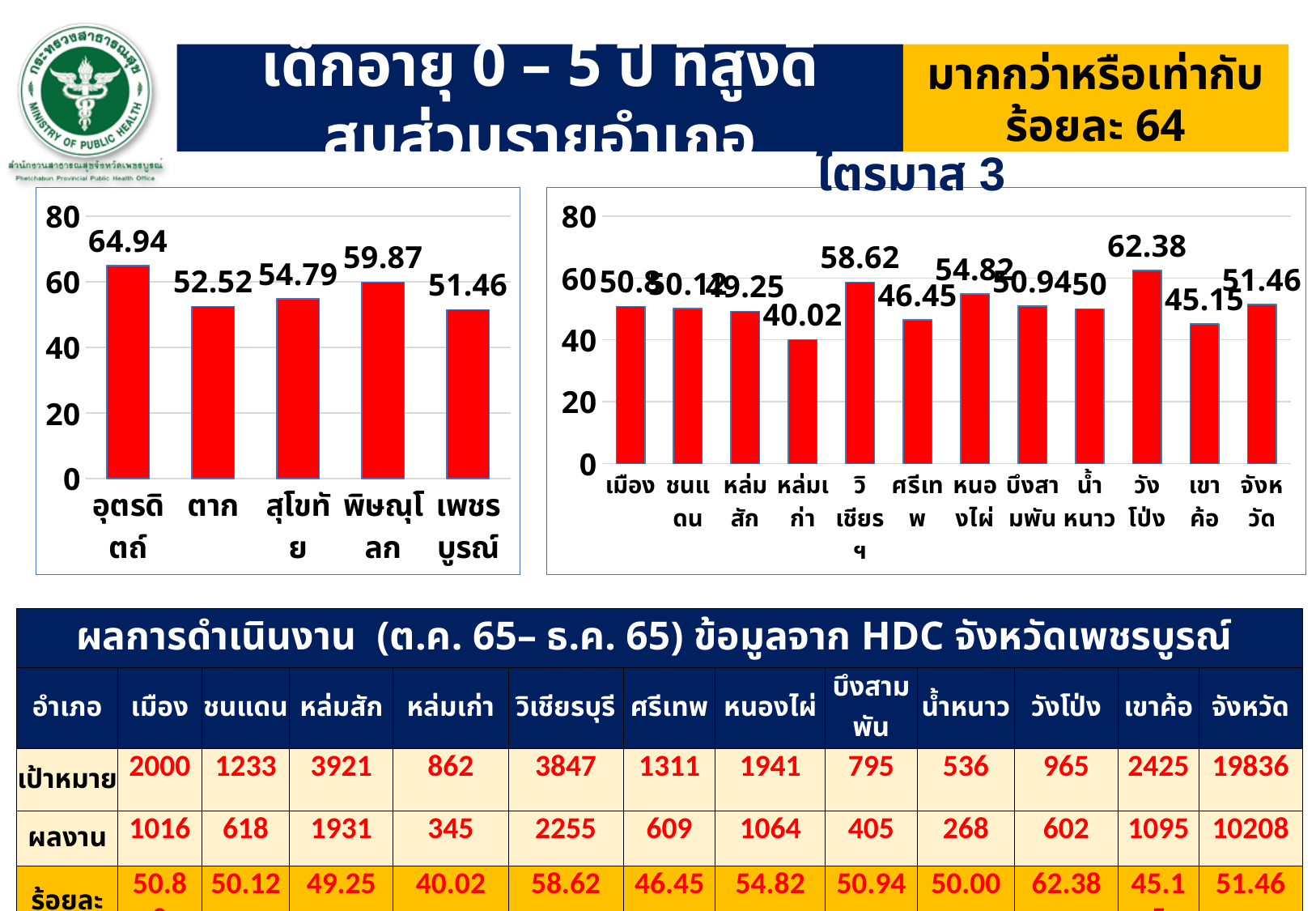
On the right chart, which is larger, the value for วิเชียรบุรี or the value for ศรีเทพ? วิเชียรบุรี On the left chart, what is the value for อุตรดิตถ์? 64.94 On the left chart, which category has the highest value? อุตรดิตถ์ On the right chart, which category has the lowest value? หล่มเก่า On the left chart, what is the value for พิษณุโลก? 59.87 On the left chart, how many categories are shown? 5 On the left chart, which category has the lowest value? เพชรบูรณ์ On the right chart, what is the value for หล่มเก่า? 40.02 On the left chart, what is the difference between the values for อุตรดิตถ์ and ตาก? 12.42 On the right chart, what is the value for วังโป่ง? 62.38 On the right chart, which category has the highest value? วังโป่ง What type of chart is the right chart? bar chart